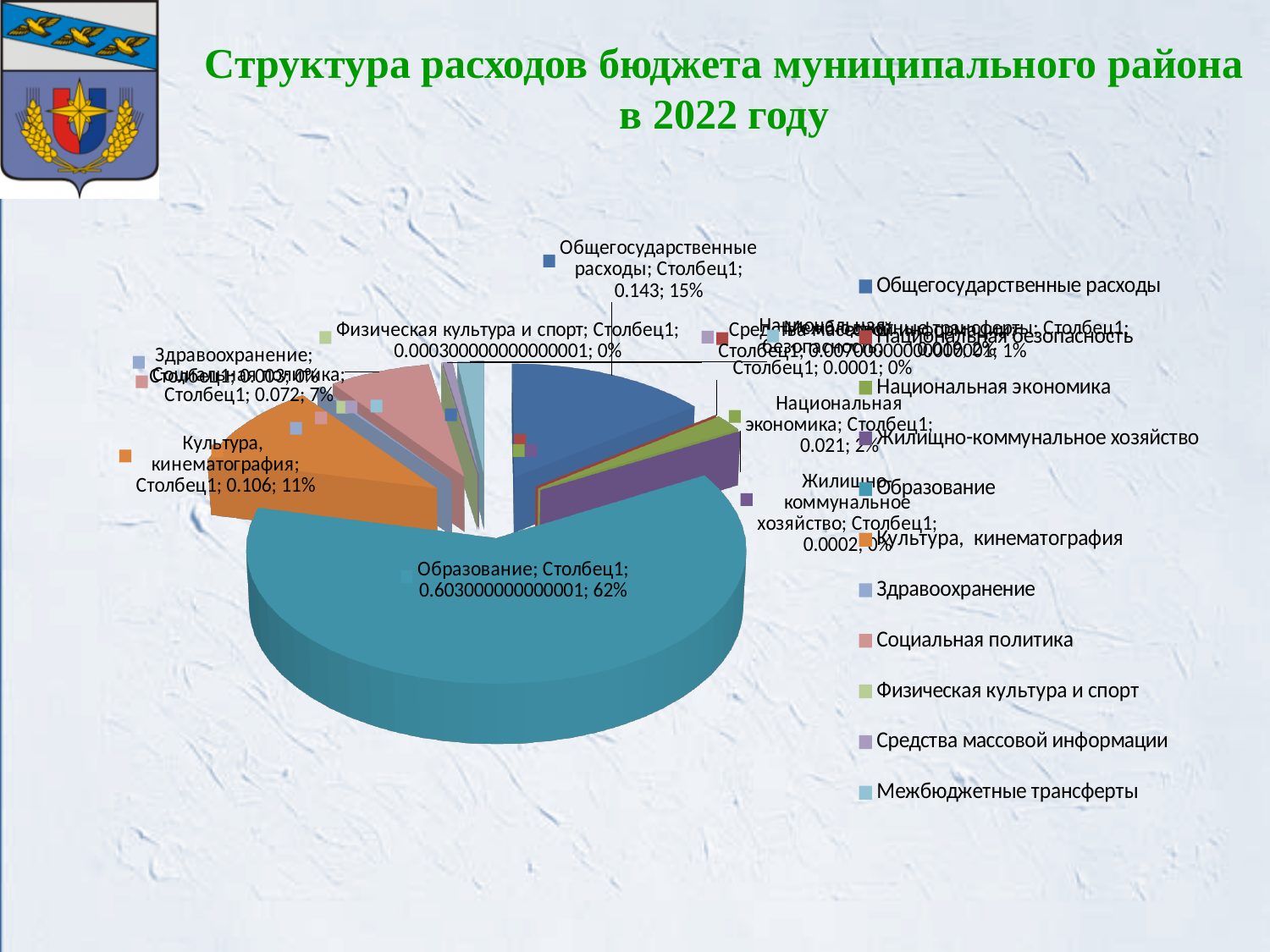
What percentage share does Общегосударственные расходы have in the pie chart? 15% What value is printed for Национальная экономика in the pie chart's data label? 0.021 What percentage share does Культура, кинематография have in the pie chart? 11% What percentage share does Образование have in the pie chart? 62% How many categories does the legend of the pie chart list? 11 What is the title of the chart on the slide? Структура расходов бюджета муниципального района в 2022 году What kind of chart is shown on the slide? pie chart What is the difference in percentage points between the shares of Образование and Общегосударственные расходы? 47 Which is larger in the pie chart: Общегосударственные расходы or Культура, кинематография? Общегосударственные расходы Which category has the largest slice in the pie chart? Образование